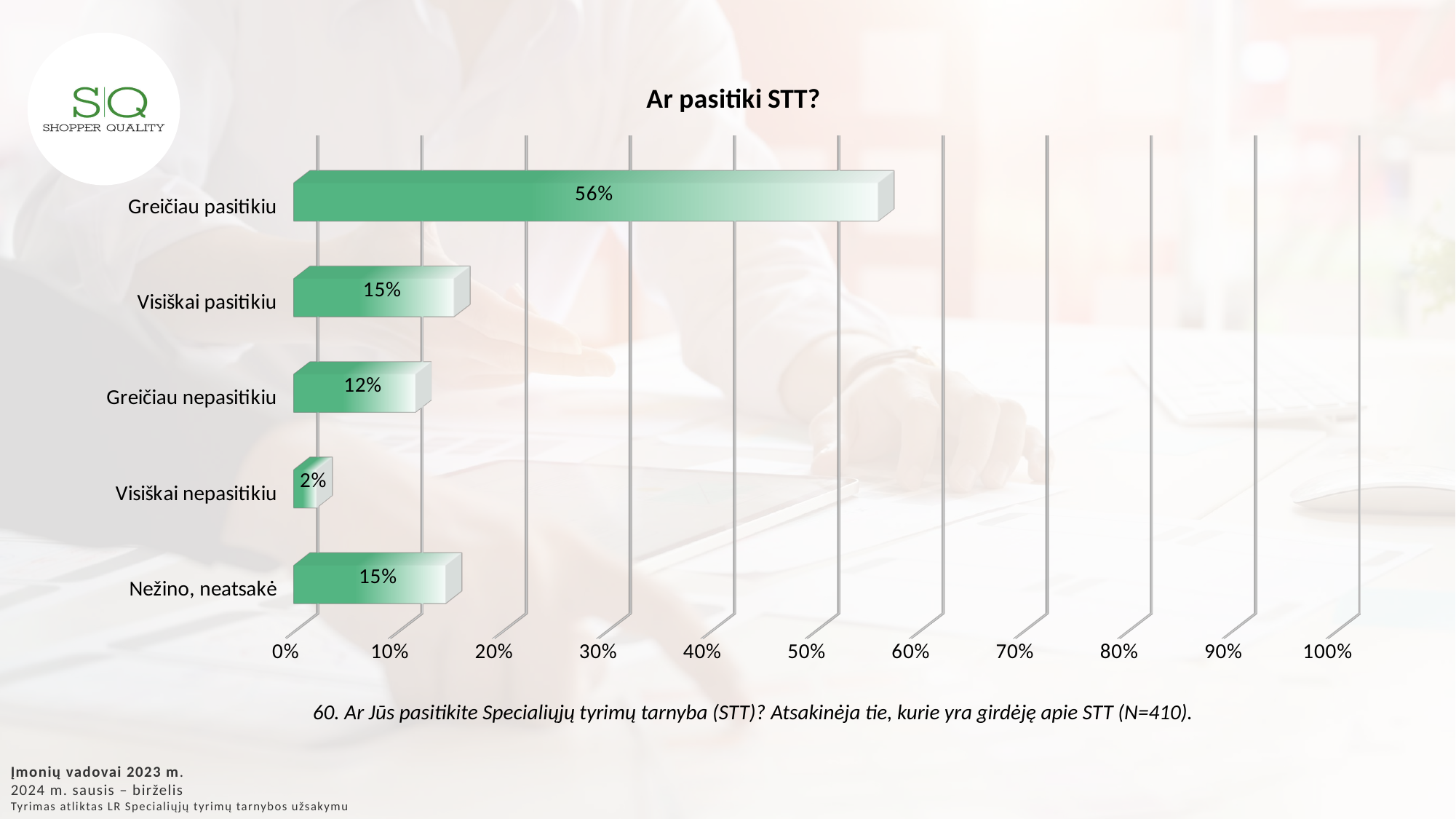
What is the value for "Nežino, neatsakė"? 15% What is the value for "Visiškai pasitikiu"? 15% What is the value for "Greičiau pasitikiu"? 56% How many categories are shown in the chart? 5 Which is larger, the value for "Greičiau nepasitikiu" or the value for "Visiškai nepasitikiu"? Greičiau nepasitikiu What is the value for "Visiškai nepasitikiu"? 2% Which category has the lowest value? Visiškai nepasitikiu What kind of chart is shown on the slide? Bar chart What is the value for "Greičiau nepasitikiu"? 12% What is the difference between the values for "Greičiau pasitikiu" and "Visiškai pasitikiu"? 41% What is the title of the chart? Ar pasitiki STT? Which category has the highest value? Greičiau pasitikiu